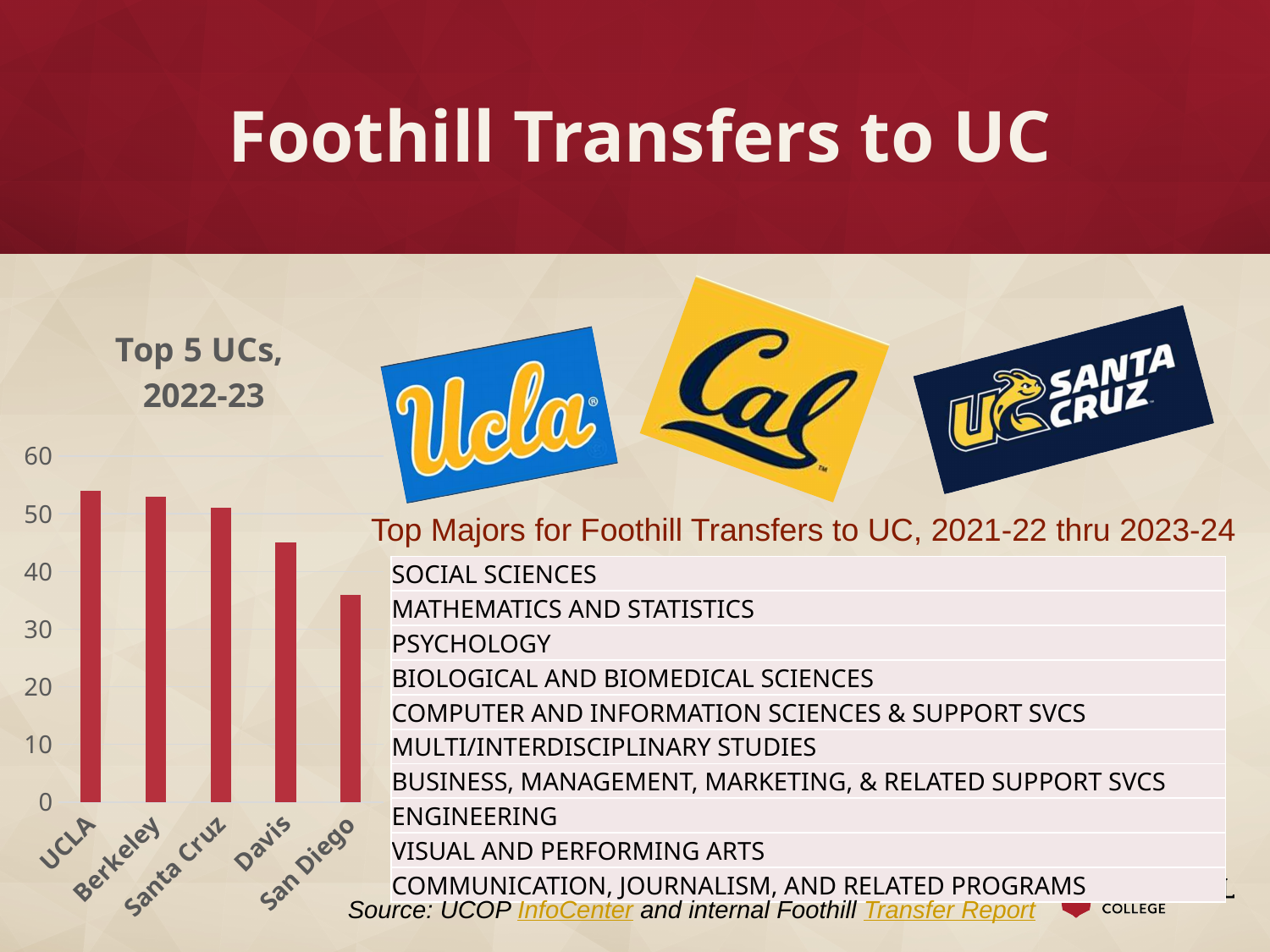
Is the value for UCLA greater or less than 50? greater Is the value for Davis greater or less than 50? less Which is larger, the value for UCLA or the value for San Diego? UCLA Is the value for Davis greater or less than 40? greater What kind of chart is shown on the slide? bar chart How many UC campuses are shown in the bar chart? 5 Do the bar values rise or fall from left to right across the campuses? fall What is the title of the bar chart? Top 5 UCs, 2022-23 Which UC campus has the lowest bar in the chart? San Diego Which is larger, the value for Berkeley or the value for Davis? Berkeley